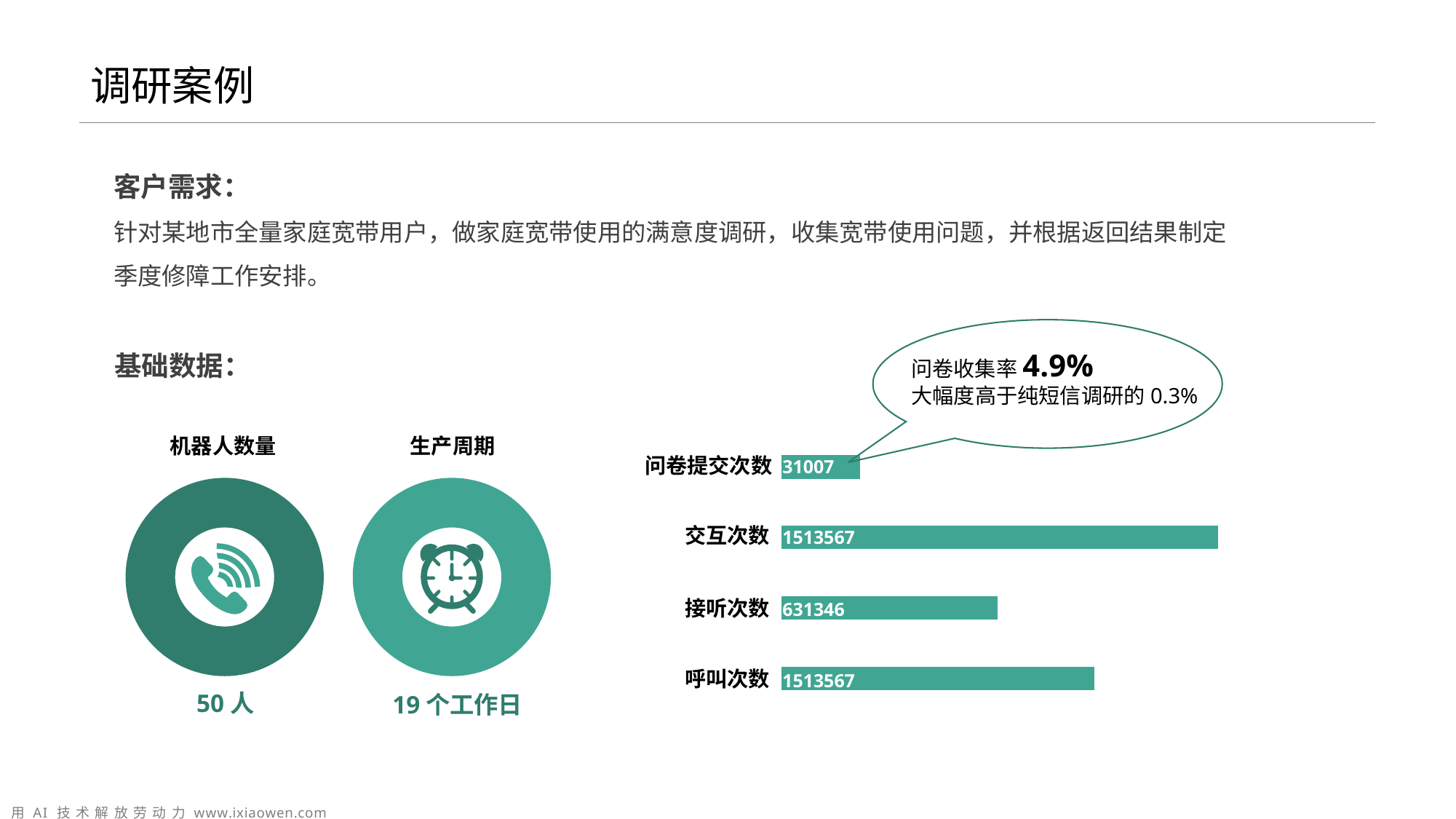
What is the value for 问卷提交次数 in the bar chart? 31007 What is the value for 接听次数 in the bar chart? 631346 Which is larger, the value for 接听次数 or the value for 问卷提交次数? 接听次数 What is the difference between the values for 接听次数 and 问卷提交次数? 600339 How many categories are shown in the bar chart? 4 What kind of chart is used to show the 基础数据 counts? bar chart According to the callout on the bar chart, what is the 问卷收集率? 4.9% Which category has the lowest value in the bar chart? 问卷提交次数 What is the value for 交互次数 in the bar chart? 1513567 What is the value for 呼叫次数 in the bar chart? 1513567 Which is larger, the value for 交互次数 or the value for 接听次数? 交互次数 What is the difference between the values for 交互次数 and 接听次数? 882221